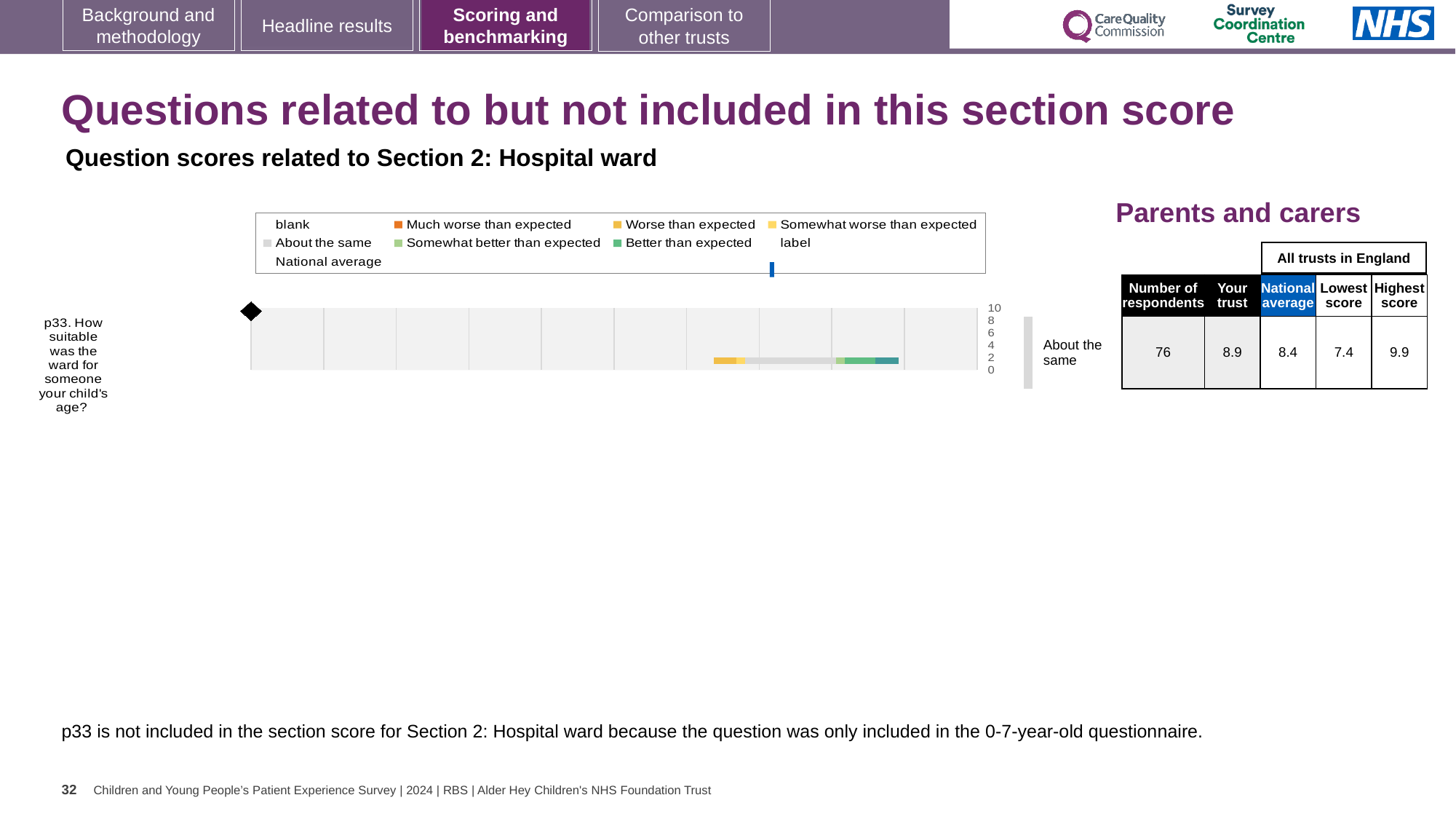
What is the 'Your trust' score for question p33 (How suitable was the ward for someone your child's age?)? 8.9 What is the lowest score among all trusts in England for question p33? 7.4 How many respondents answered question p33? 76 Which is larger for p33: the trust's score or the national average? Your trust By how much does the trust's score for p33 exceed the national average? 0.5 What kind of chart is used to show the p33 benchmarking result? Bar chart Which benchmarking category is the trust's p33 result assigned to? About the same What is the national average score for question p33? 8.4 What is the maximum value shown on the chart's score axis? 10 What is the highest score among all trusts in England for question p33? 9.9 What is the difference between the highest and lowest trust scores for p33? 2.5 How many survey questions are plotted in the chart? 1